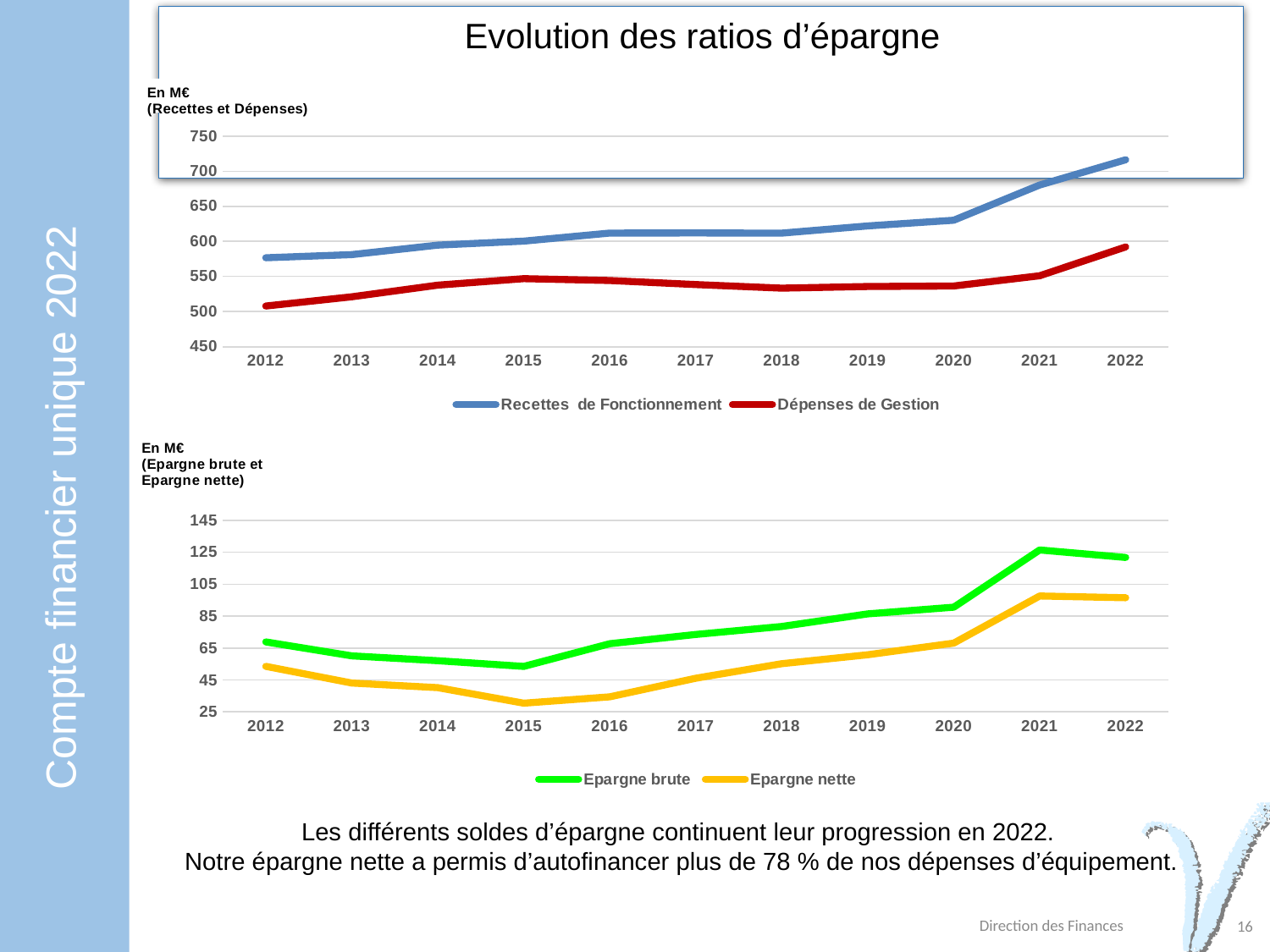
How many series does the legend of the top chart (Recettes et Dépenses) list? 2 In the bottom chart (Epargne brute et Epargne nette), in which year is Epargne brute lowest? 2015 In the top chart (Recettes et Dépenses), in which year is Recettes de Fonctionnement highest? 2022 In the top chart (Recettes et Dépenses), in which year is Dépenses de Gestion lowest? 2012 In the top chart (Recettes et Dépenses), is the value for Dépenses de Gestion in 2012 greater or less than 550? less What kind of chart is the top chart (Recettes et Dépenses)? line chart In the bottom chart (Epargne brute et Epargne nette), in which year is Epargne brute highest? 2021 In the top chart (Recettes et Dépenses), which series is higher in 2022, Recettes de Fonctionnement or Dépenses de Gestion? Recettes de Fonctionnement In the bottom chart (Epargne brute et Epargne nette), does Epargne brute rise or fall from 2015 to 2021? rise In the top chart (Recettes et Dépenses), is the value for Recettes de Fonctionnement in 2022 greater or less than 700? greater How many years are shown on the x axis of the top chart (Recettes et Dépenses)? 11 In the bottom chart (Epargne brute et Epargne nette), is the value for Epargne nette in 2015 greater or less than 45? less